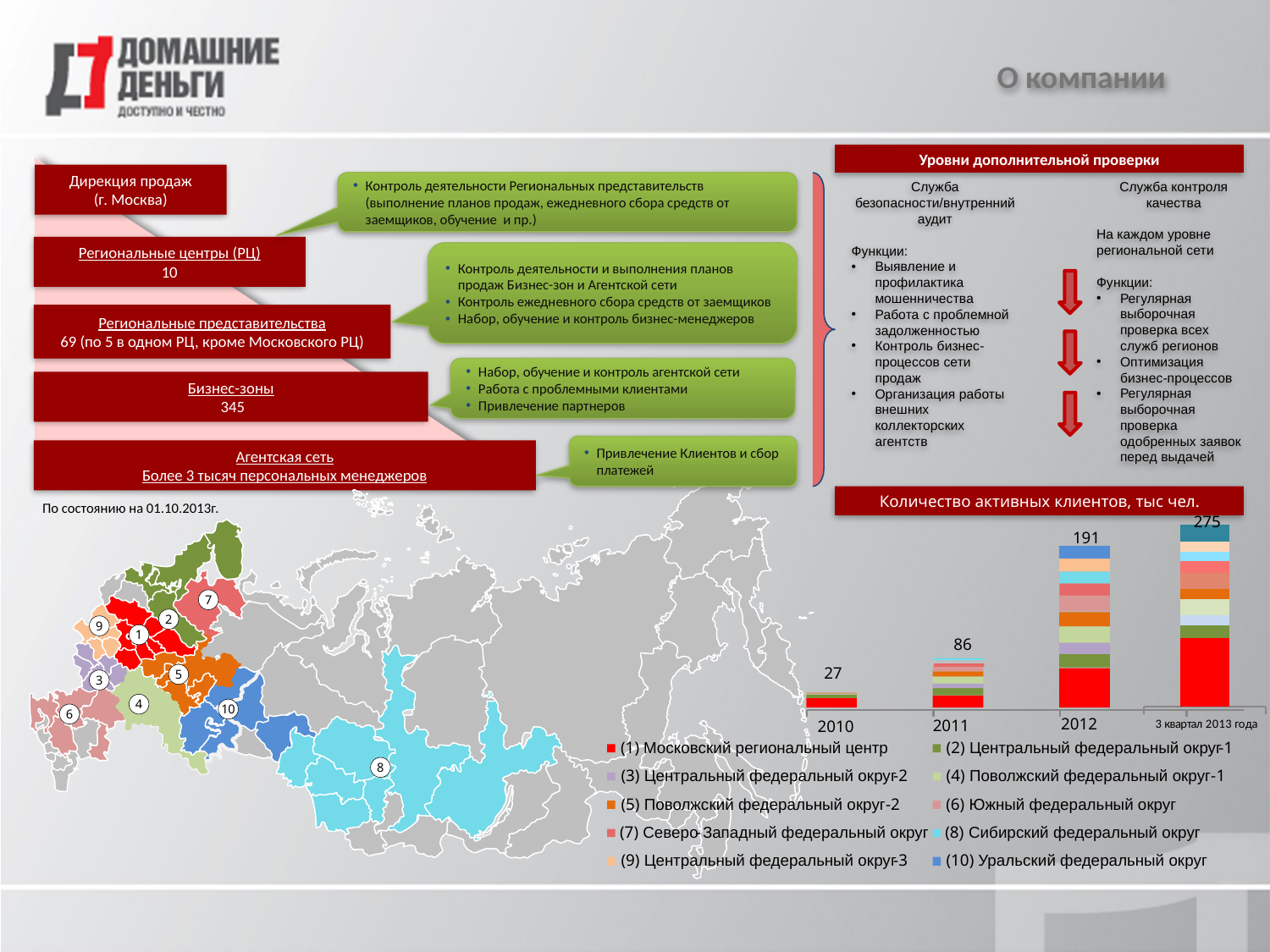
By how much did the total number of active clients increase from 2011 to 2012? 105 Do the total values of active clients rise or fall from 2010 to 3 квартал 2013 года? Rise Which period has the highest total number of active clients? 3 квартал 2013 года How many periods are shown on the x axis of the chart? 4 What is the total number of active clients (тыс чел.) shown for 2012? 191 What is the total number of active clients (тыс чел.) shown for 2011? 86 How many series does the chart legend list? 10 What is the total number of active clients (тыс чел.) shown for 3 квартал 2013 года? 275 What is the title of the chart on the slide? Количество активных клиентов, тыс чел. Which period has the lowest total number of active clients? 2010 What type of chart is used to show the number of active clients? Stacked bar chart